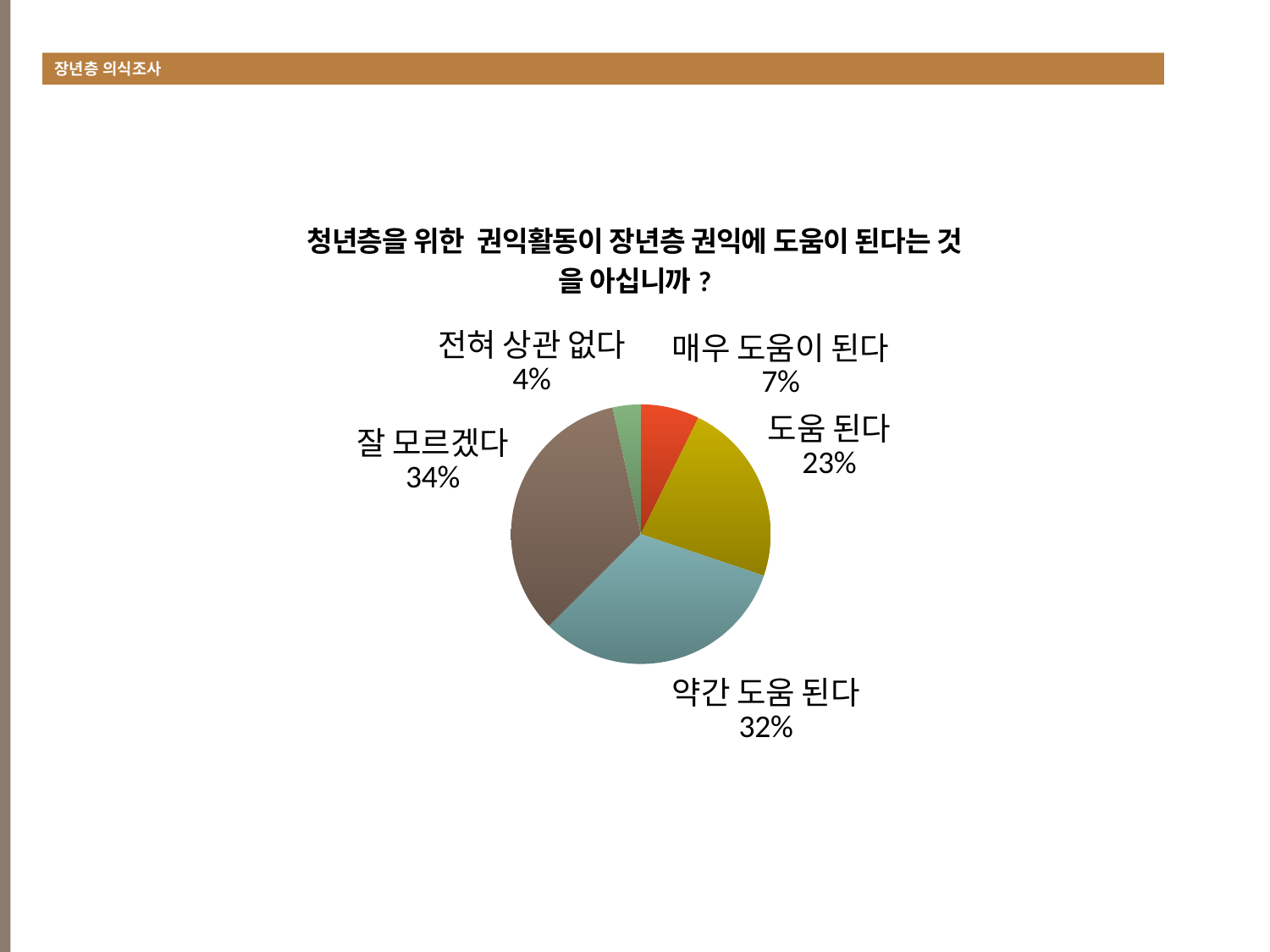
What is the difference between the values for '약간 도움 된다' and '도움 된다'? 9% Which is larger, the value for '매우 도움이 된다' or the value for '전혀 상관 없다'? 매우 도움이 된다 How many categories are shown in the pie chart? 5 What is the value shown for '매우 도움이 된다'? 7% What is the value shown for '도움 된다'? 23% Which category has the smallest slice of the pie? 전혀 상관 없다 Which category has the largest slice of the pie? 잘 모르겠다 What kind of chart is shown on the slide? Pie chart What is the value shown for '전혀 상관 없다'? 4% What is the combined value of '매우 도움이 된다' and '도움 된다'? 30% What share of the pie does '잘 모르겠다' represent? 34% What is the title of the chart? 청년층을 위한 권익활동이 장년층 권익에 도움이 된다는 것을 아십니까 ?